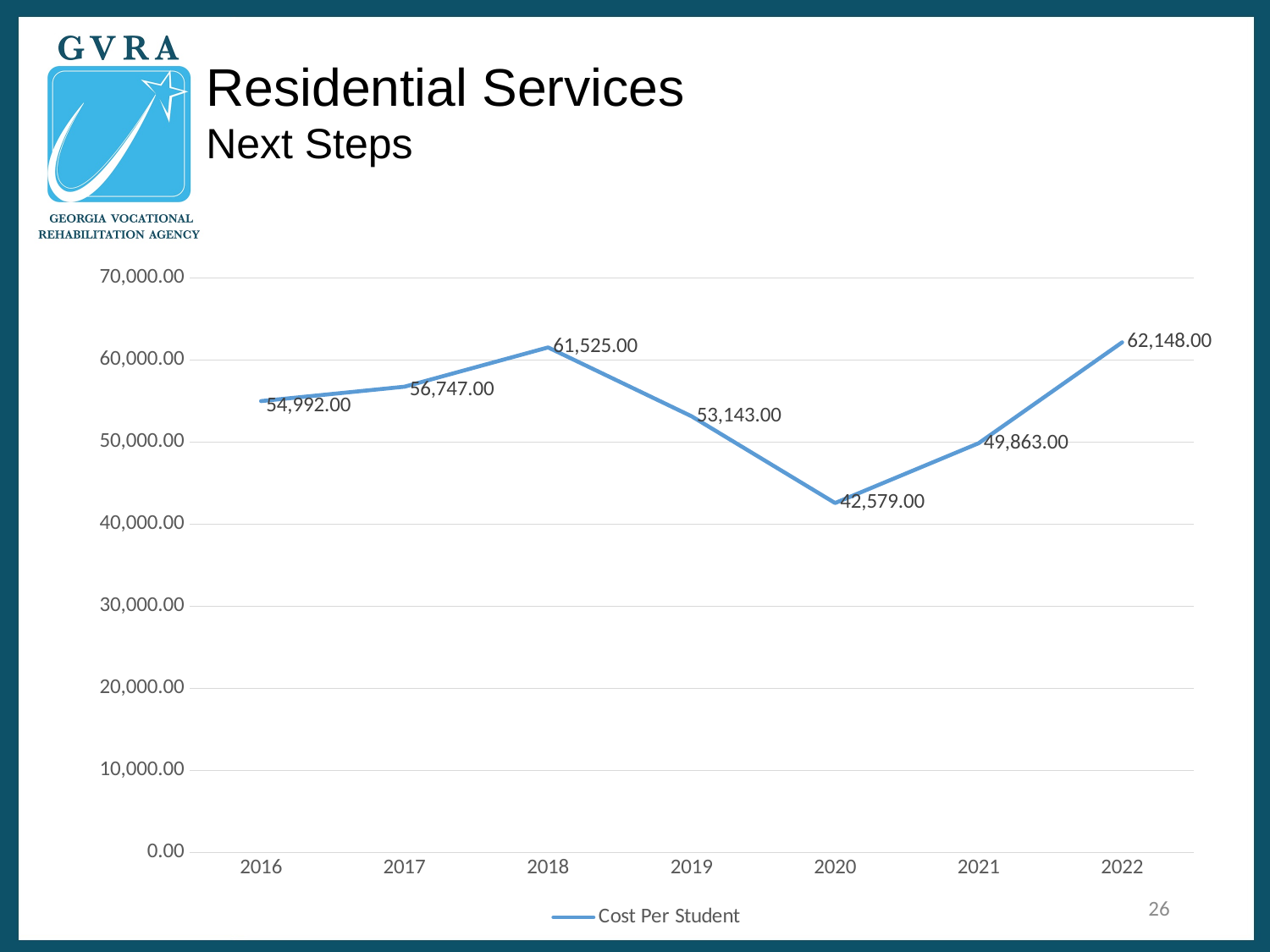
What is the difference between the Cost Per Student in 2022 and in 2020? 19,569.00 What is the Cost Per Student for 2016? 54,992.00 How many series does the legend list? 1 What is the Cost Per Student for 2020? 42,579.00 Which year has the highest Cost Per Student? 2022 Which year has the lowest Cost Per Student? 2020 What is the Cost Per Student for 2018? 61,525.00 Which year has a higher Cost Per Student, 2017 or 2019? 2017 How many years are plotted on the chart? 7 Does the Cost Per Student rise or fall from 2018 to 2020? fall Is the Cost Per Student for 2021 greater or less than 50,000.00? less What kind of chart is shown on the slide? line chart